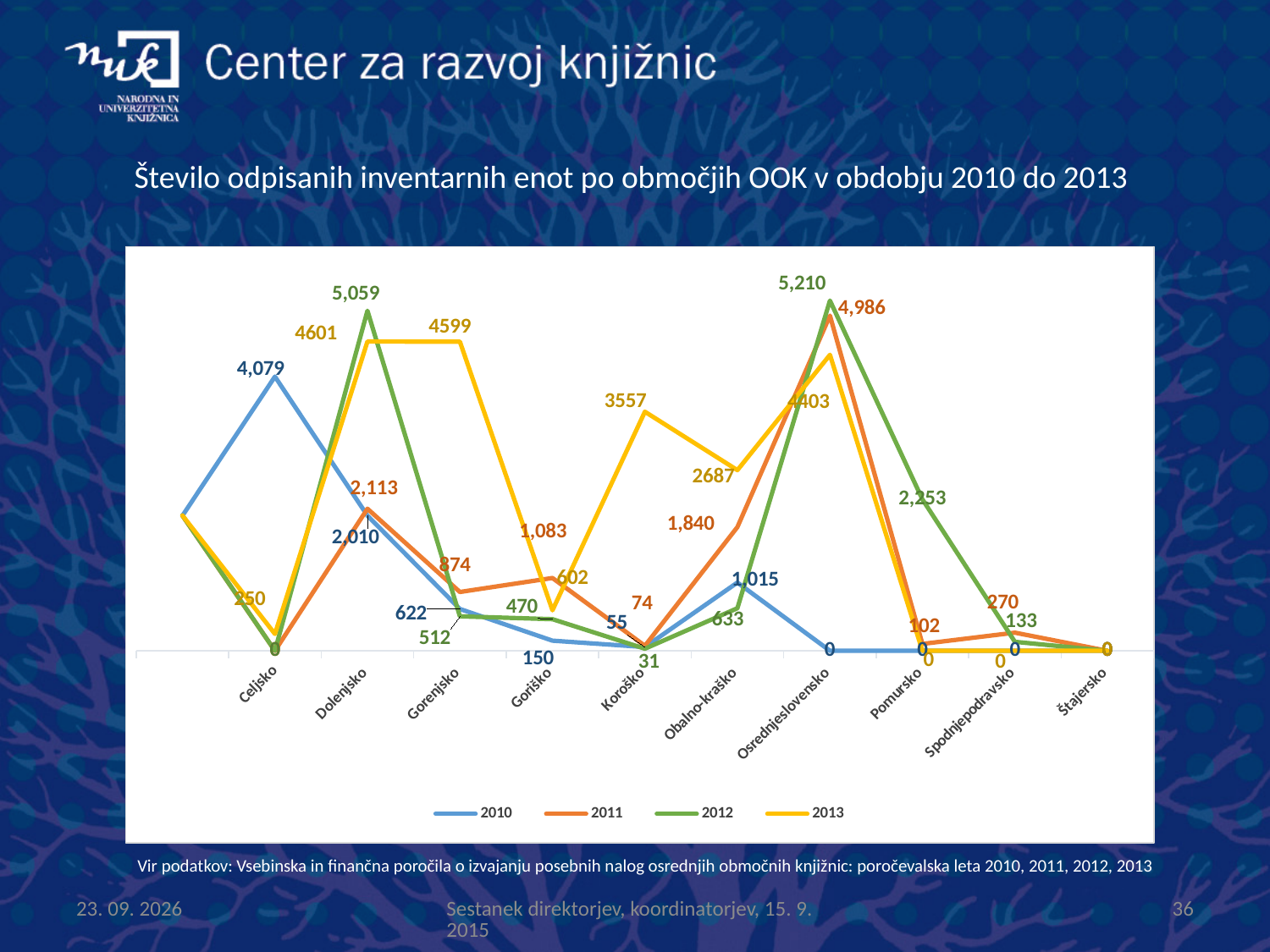
How many series does the legend list? 4 What is the value for Pomursko in the 2012 series? 2,253 What is the difference between the 2013 values for Dolenjsko and Gorenjsko? 2 What is the value for Dolenjsko in the 2012 series? 5,059 What is the value for Gorenjsko in the 2011 series? 874 What kind of chart is shown on the slide? line chart Which region has the highest value in the 2012 series? Osrednjeslovensko What is the difference between the 2012 and 2011 values for Osrednjeslovensko? 224 For Obalno-kraško, which series has the larger value, 2010 or 2011? 2011 Which region has the highest value in the 2010 series? Celjsko What are the legend entries of the chart? 2010, 2011, 2012, 2013 What is the value for Koroško in the 2013 series? 3557